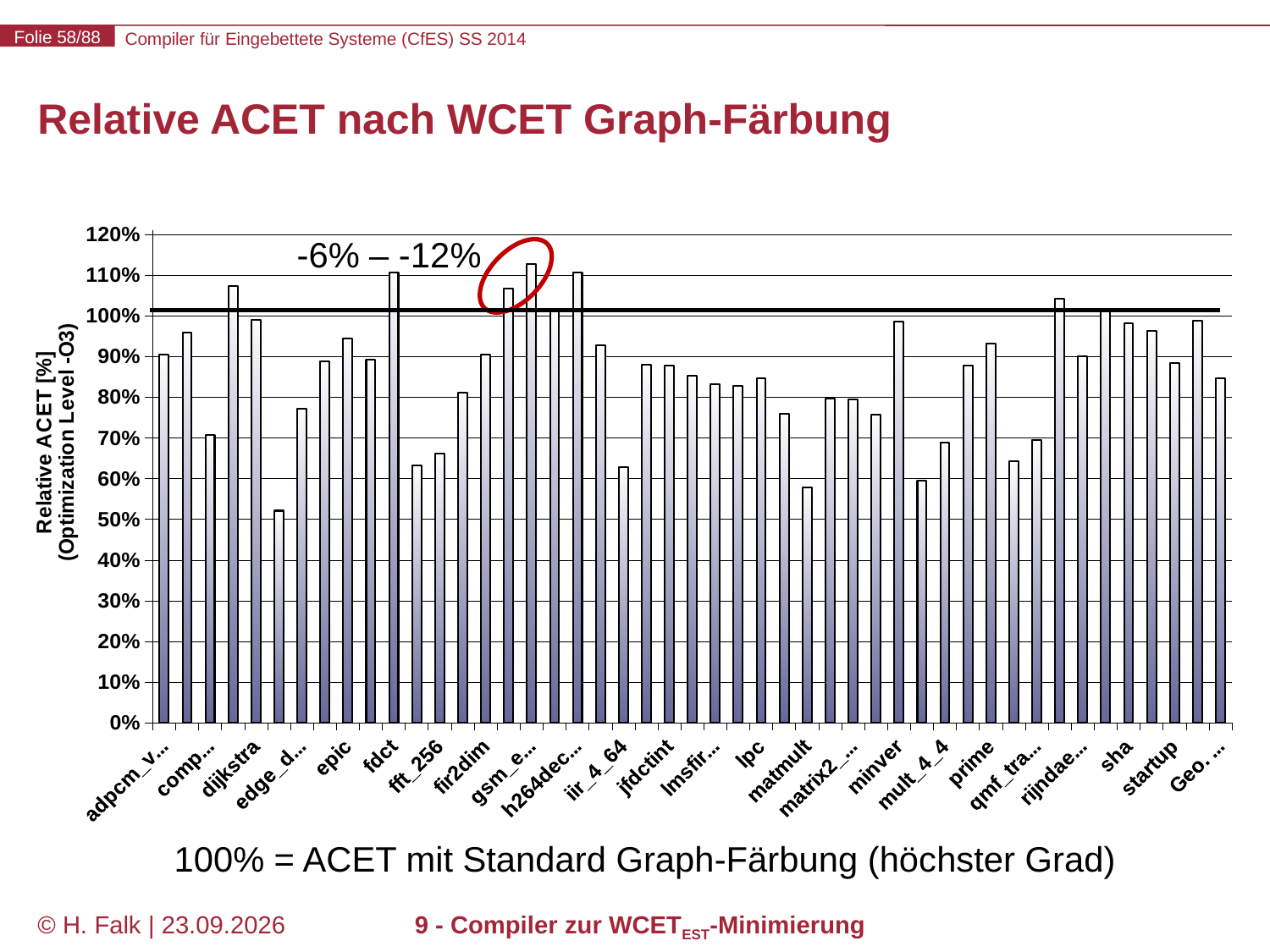
Is the value for lpc greater or less than 90%? less Is the value for qmf_tra... greater or less than 80%? less Is the value for epic greater or less than 100%? less What is the highest tick value shown on the vertical axis of the chart? 120% What is the title of the chart on the slide? Relative ACET nach WCET Graph-Färbung What is the label of the vertical axis of the chart? Relative ACET [%] (Optimization Level -O3) What kind of chart is shown on the slide? bar chart